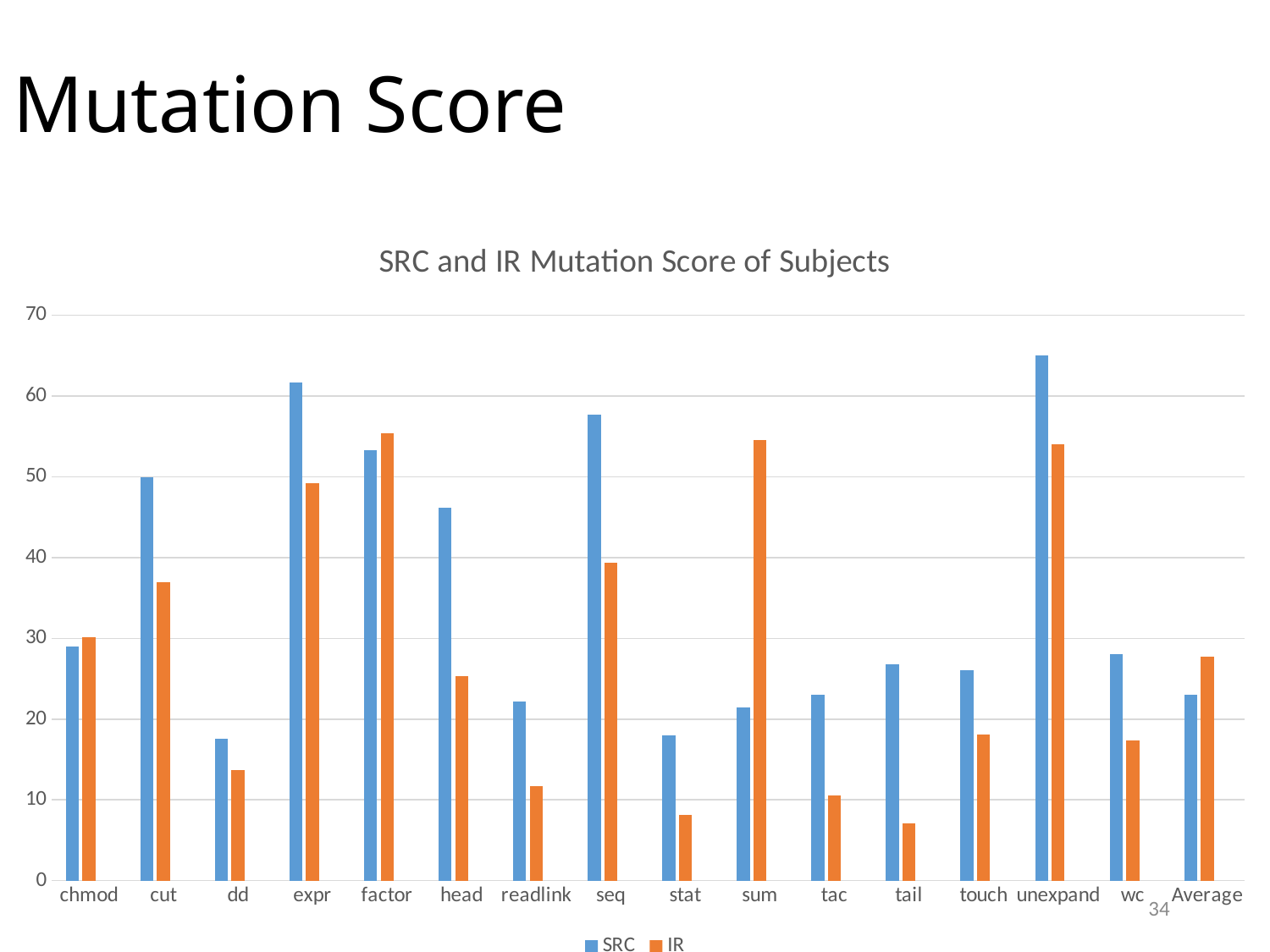
Is the SRC value for dd greater or less than 20? less What kind of chart is shown on the slide? bar chart Which category has the highest SRC value? unexpand What is the title of the chart? SRC and IR Mutation Score of Subjects Is the IR value for tail greater or less than 10? less For cut, which series has the larger value, SRC or IR? SRC For sum, which series has the larger value, SRC or IR? IR How many series does the legend list? 2 Is the SRC value for expr greater or less than 60? greater How many categories are shown on the x axis? 16 For Average, which series has the larger value, SRC or IR? IR